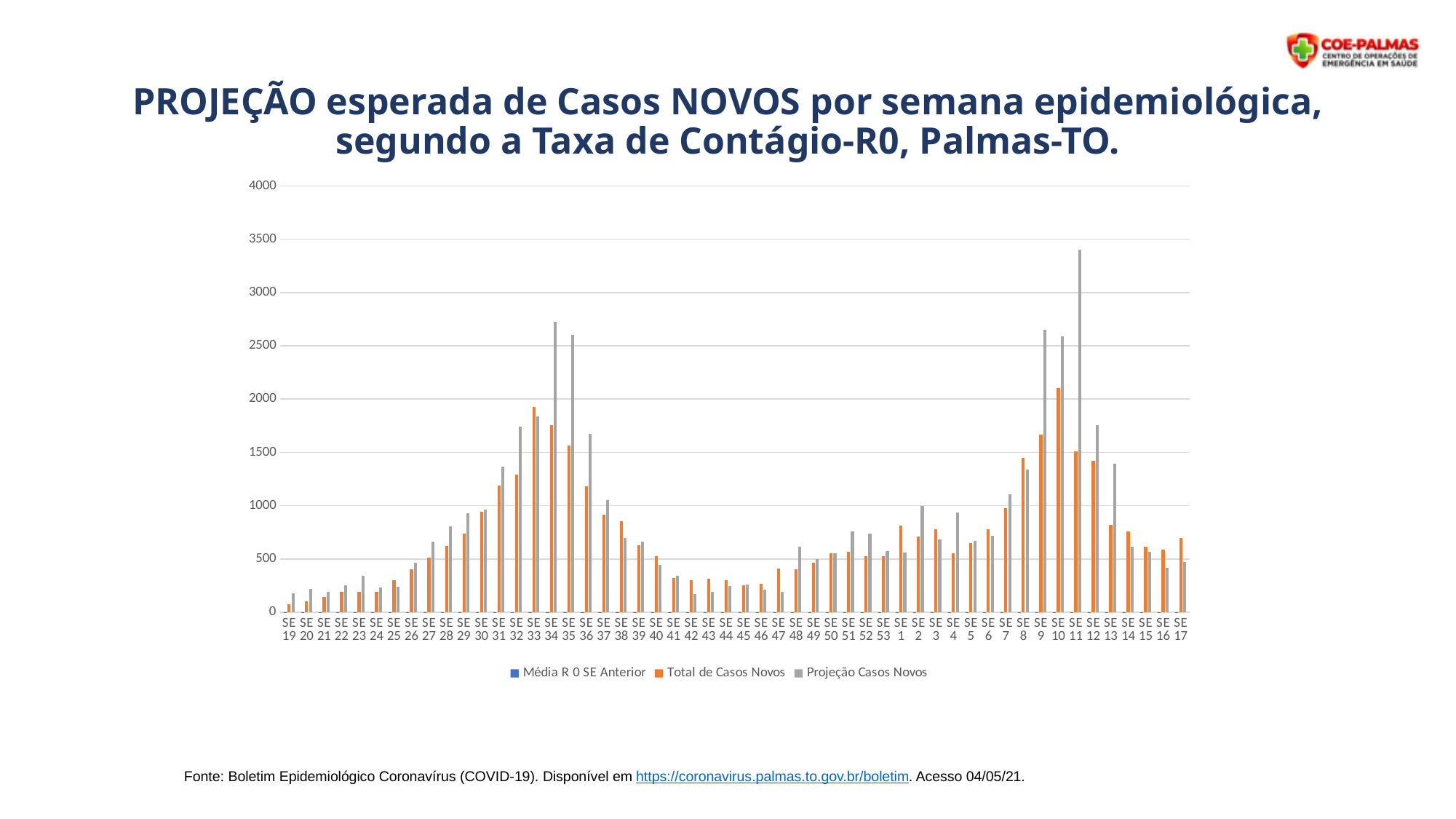
Which week has the highest value for Total de Casos Novos? SE 10 Is the Total de Casos Novos value for SE 42 greater or less than 500? less Is the Total de Casos Novos value for SE 10 greater or less than 2000? greater Is the Projeção Casos Novos value for SE 11 greater or less than 3000? greater How many series does the legend list? 3 For SE 10, which is larger: Total de Casos Novos or Projeção Casos Novos? Projeção Casos Novos Does the Total de Casos Novos series rise or fall from SE 19 to SE 33? Rise Which week has the highest value for Projeção Casos Novos? SE 11 Which is larger: the Projeção Casos Novos value for SE 11 or for SE 34? SE 11 How many epidemiological weeks (categories) are shown on the x axis? 52 What kind of chart is shown on the slide? Bar chart